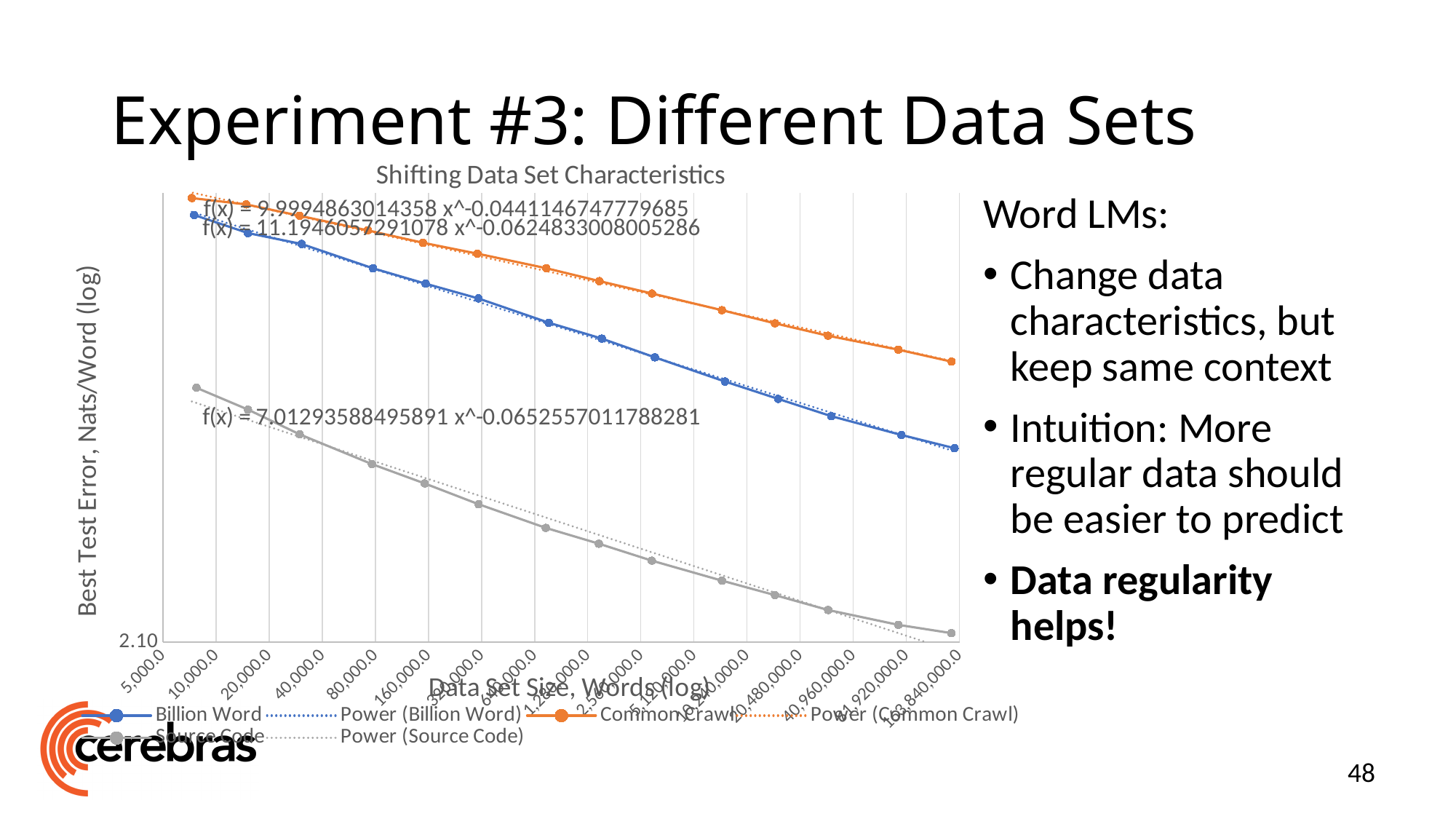
Which series has the highest best test error across the data set sizes? Common Crawl Which series has the lowest best test error across the data set sizes? Source Code At a data set size of 163,840,000.0 words, which series has the higher best test error, Common Crawl or Billion Word? Common Crawl What is the coefficient in the power trendline equation for Common Crawl, f(x) = ? x^-0.0441146747779685? 9.9994863014358 What is the label of the y axis? Best Test Error, Nats/Word (log) What is the title of the chart? Shifting Data Set Characteristics What kind of chart is shown on the slide? line chart What is the exponent in the power trendline equation for Source Code, f(x) = 7.01293588495891 x^? -0.0652557011788281 Is the Source Code value at 163,840,000.0 words greater or less than 2.10? greater Does the Billion Word series rise or fall as data set size increases? fall Does the Source Code series rise or fall as data set size increases? fall How many entries does the chart legend list? 6